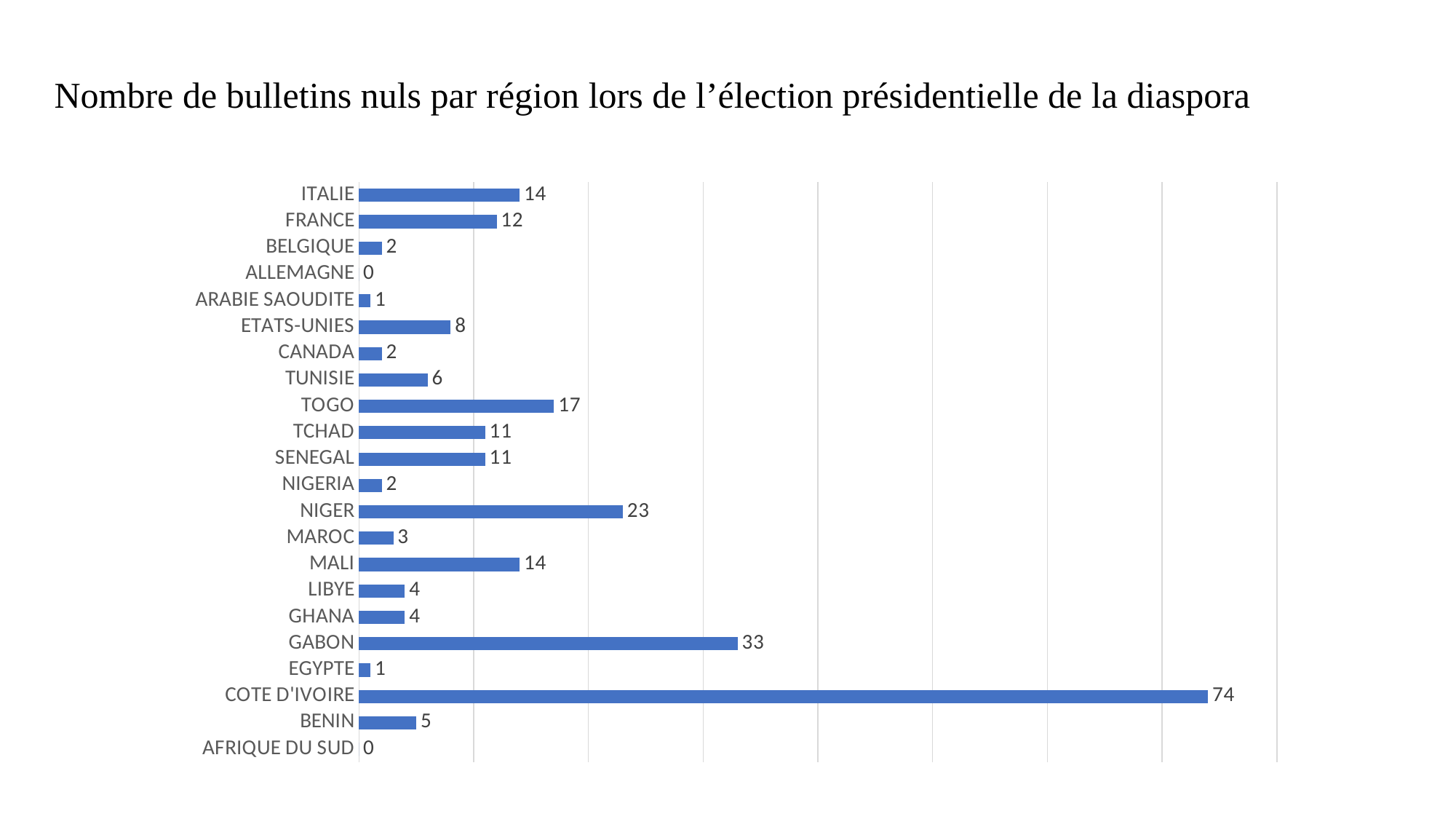
What is the value shown for ETATS-UNIES? 8 What is the difference between the values for COTE D'IVOIRE and GABON? 41 How many regions are shown on the chart? 22 Which has a larger value, NIGER or TOGO? NIGER What is the title of the slide? Nombre de bulletins nuls par région lors de l'élection présidentielle de la diaspora What is the number of null ballots for GABON? 33 What is the value shown for NIGER? 23 What is the difference between the values for ITALIE and FRANCE? 2 What is the value shown for TOGO? 17 Which region has the highest number of null ballots? COTE D'IVOIRE What kind of chart is shown on the slide? Bar chart Which has a larger value, TUNISIE or BENIN? TUNISIE